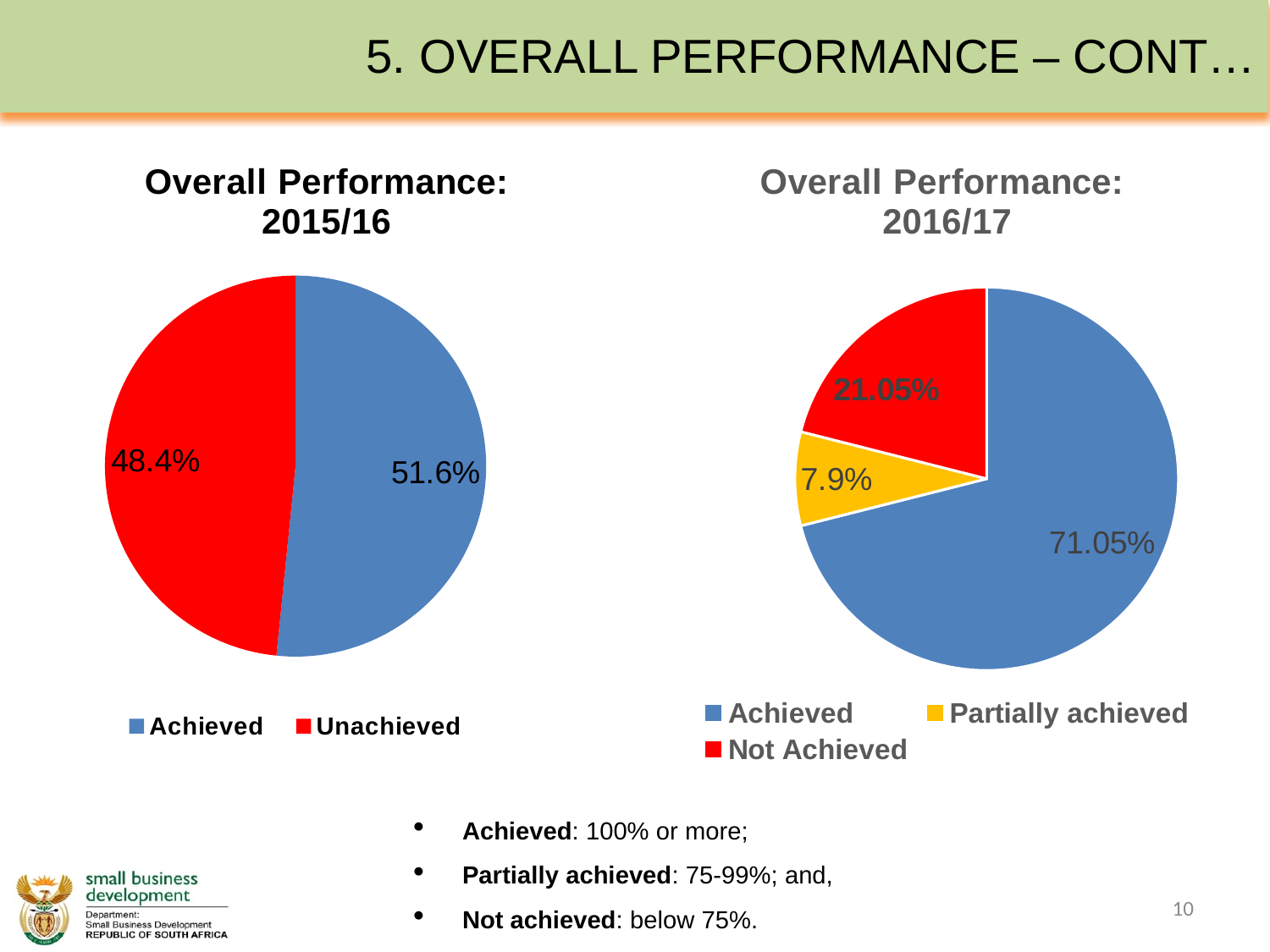
In the 'Overall Performance: 2016/17' chart, which category has the smallest share? Partially achieved In the 'Overall Performance: 2016/17' chart, what is the value for Not Achieved? 21.05% In the 'Overall Performance: 2016/17' chart, what is the value for Partially achieved? 7.9% What kind of chart is the 'Overall Performance: 2015/16' chart? Pie chart In the 'Overall Performance: 2015/16' chart, what is the difference between Achieved and Unachieved? 3.2% In the 'Overall Performance: 2015/16' chart, what is the value for Achieved? 51.6% In the 'Overall Performance: 2016/17' chart, which is larger, Not Achieved or Partially achieved? Not Achieved In the 'Overall Performance: 2016/17' chart, what is the difference between Achieved and Not Achieved? 50% In the 'Overall Performance: 2016/17' chart, what is the value for Achieved? 71.05% In the 'Overall Performance: 2015/16' chart, what is the value for Unachieved? 48.4% In the 'Overall Performance: 2016/17' chart, which category has the largest share? Achieved How many categories does the 'Overall Performance: 2016/17' chart show? 3